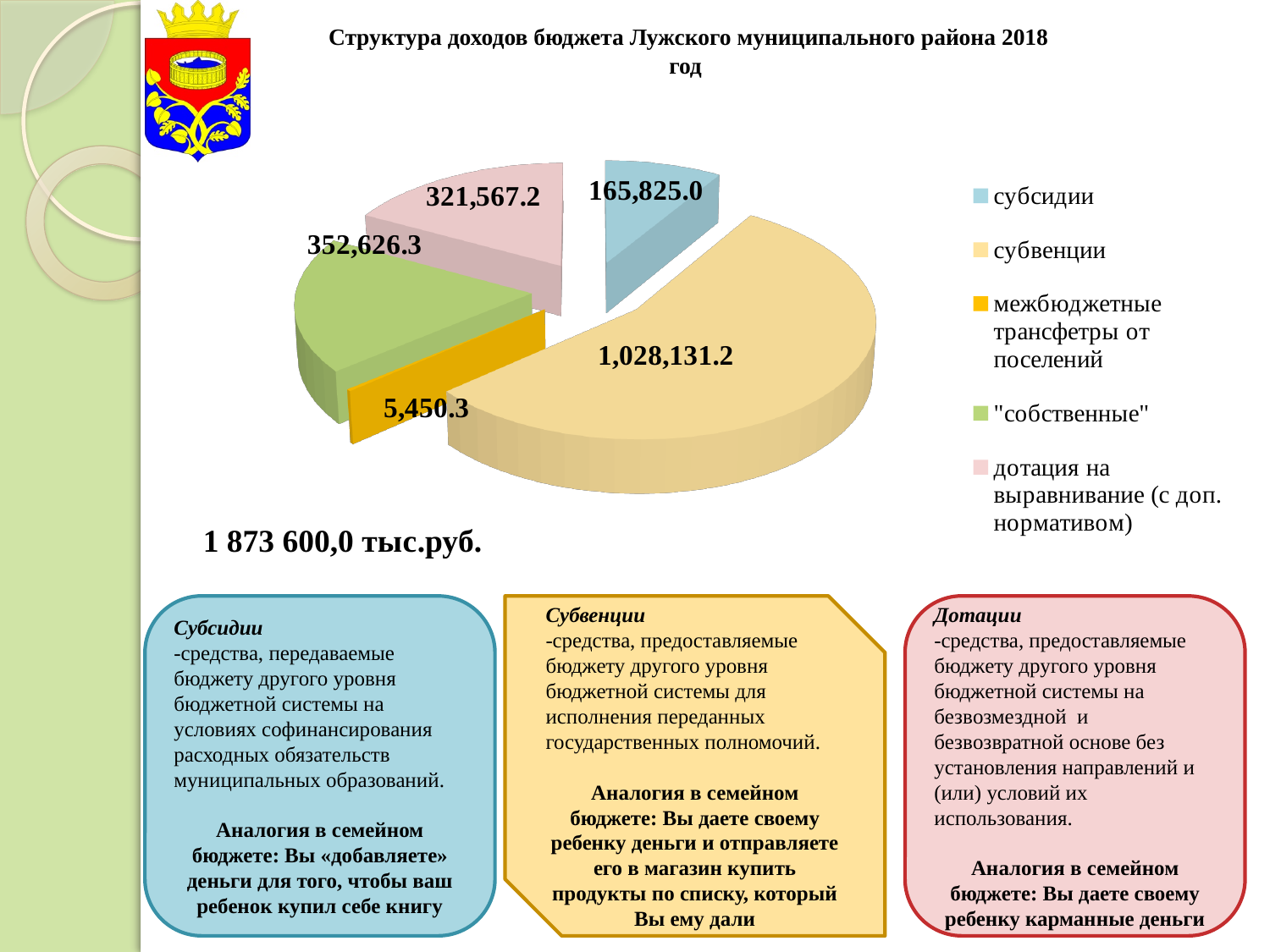
What is the value for межбюджетные трансферты от поселений in the pie chart? 5,450.3 Which category has the largest slice in the pie chart? субвенции What is the value for субсидии in the pie chart? 165,825.0 What is the value for дотация на выравнивание (с доп. нормативом) in the pie chart? 321,567.2 What colour is the slice for субвенции in the pie chart? yellow Which is larger, the value for субсидии or the value for "собственные"? "собственные" What is the difference between the values for "собственные" and дотация на выравнивание (с доп. нормативом)? 31,059.1 What is the value for субвенции in the pie chart? 1,028,131.2 How many categories does the legend of the pie chart list? 5 Which category has the smallest slice in the pie chart? межбюджетные трансферты от поселений What is the value for "собственные" in the pie chart? 352,626.3 What kind of chart is shown on the slide? pie chart